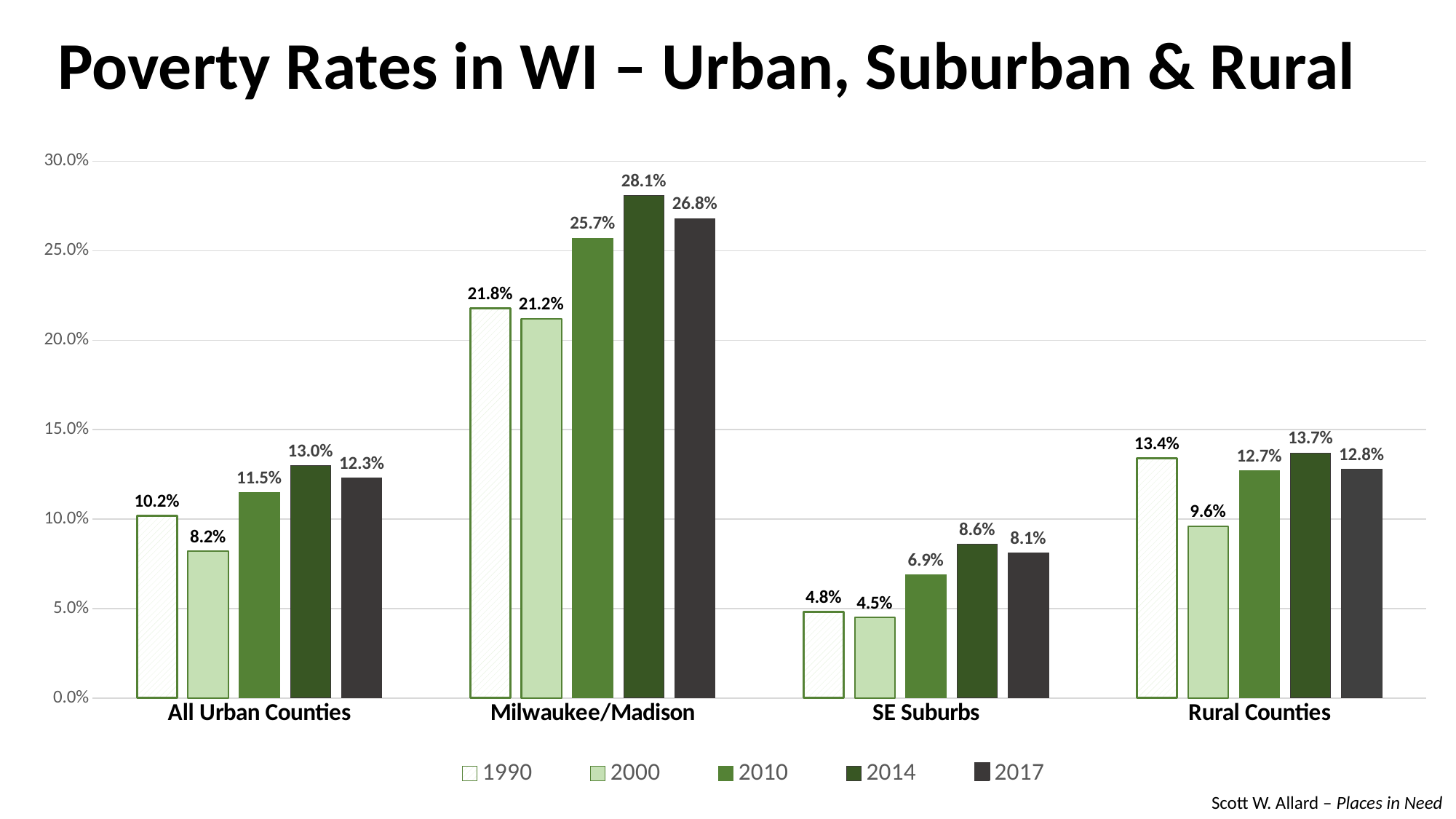
What kind of chart is shown on the slide? Bar chart Which category had the highest poverty rate in 2017? Milwaukee/Madison What is the difference between the 2014 and 1990 poverty rates for All Urban Counties? 2.8% What was the poverty rate for Milwaukee/Madison in 2014? 28.1% What was the poverty rate for SE Suburbs in 1990? 4.8% How many categories are shown on the x axis? 4 What is the title of the chart? Poverty Rates in WI – Urban, Suburban & Rural Which category had the lowest poverty rate in 2010? SE Suburbs How many series does the legend list? 5 What was the poverty rate for Rural Counties in 2000? 9.6% Did the poverty rate for SE Suburbs rise or fall from 2014 to 2017? Fall Which is larger, the 2017 poverty rate for Rural Counties or for All Urban Counties? Rural Counties